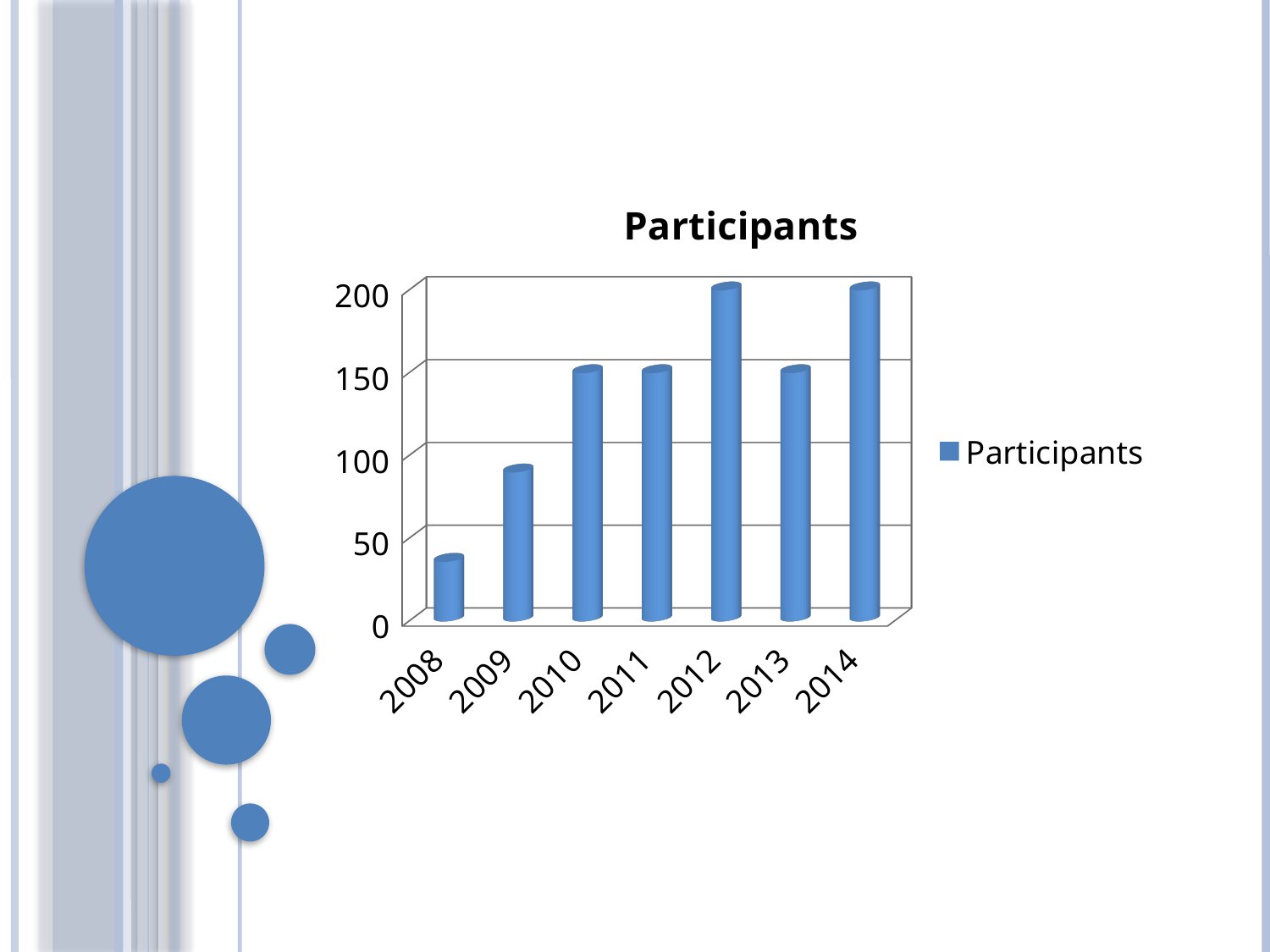
Which year has the lowest number of participants? 2008 How many series does the legend list? 1 Is the value for 2008 greater or less than 50? less What is the title of the chart? Participants How many years are shown on the x axis of the chart? 7 What type of chart is shown on the slide? bar chart What is the number of participants in 2012? 200 Is the value for 2009 greater or less than 50? greater Which year has more participants, 2009 or 2013? 2013 What is the difference in participants between 2012 and 2013? 50 What is the number of participants in 2014? 200 What is the number of participants in 2010? 150